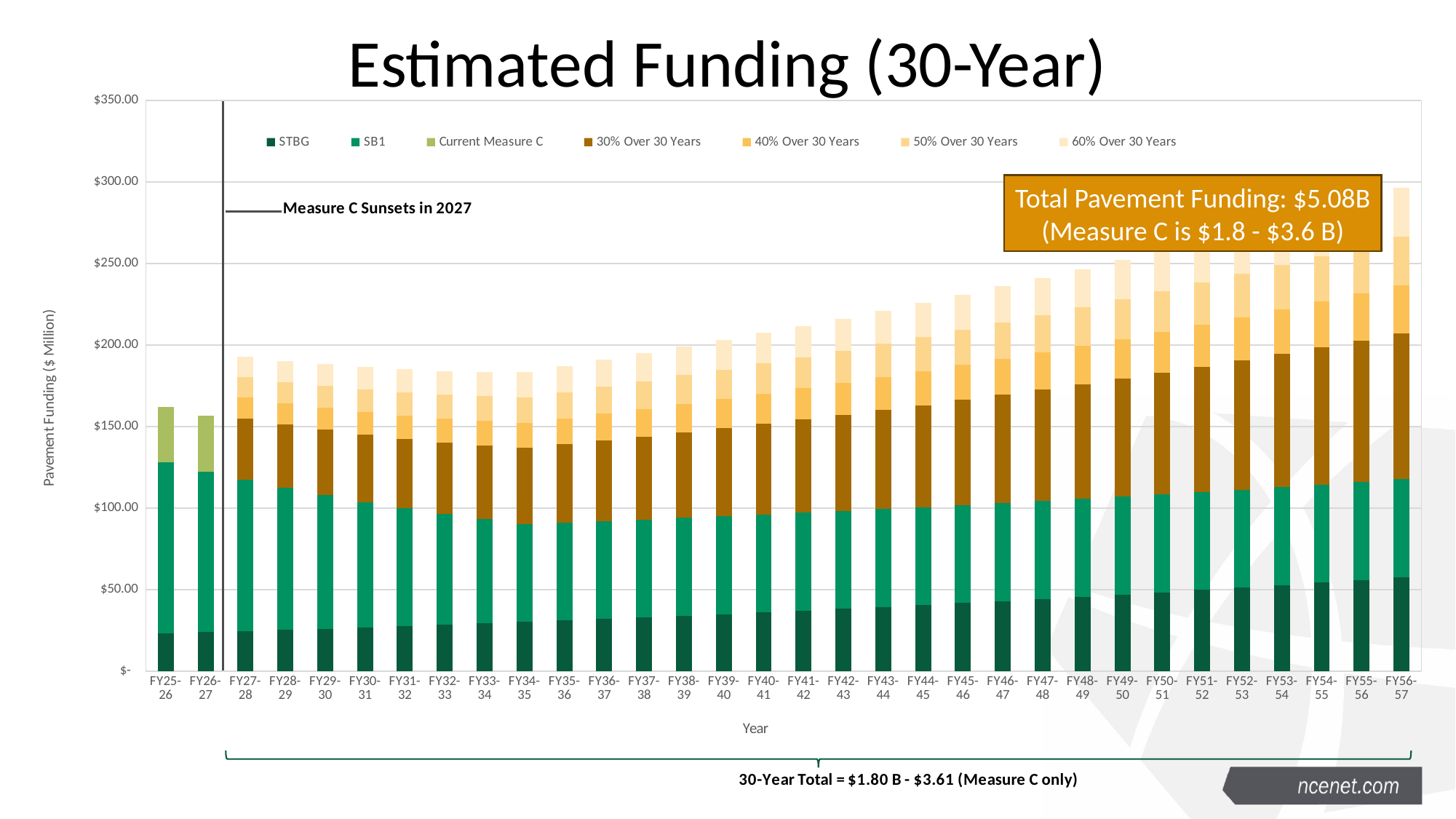
How many fiscal-year categories are plotted along the x axis? 32 Is the total bar height for FY25-26 greater or less than $150.00? greater Which fiscal year has the tallest stacked bar? FY56-57 Is the total bar height for FY56-57 greater or less than $250.00? greater Is the total bar height for FY26-27 greater or less than $200.00? less What is the title of the chart? Estimated Funding (30-Year) What kind of chart is shown on the slide? Stacked bar chart How many series does the legend list? 7 Which fiscal year has the shortest stacked bar? FY26-27 What does the annotation next to the vertical line on the chart say? Measure C Sunsets in 2027 Do the total bar heights generally rise or fall from FY35-36 to FY56-57? Rise Which has the taller stacked bar, FY27-28 or FY56-57? FY56-57